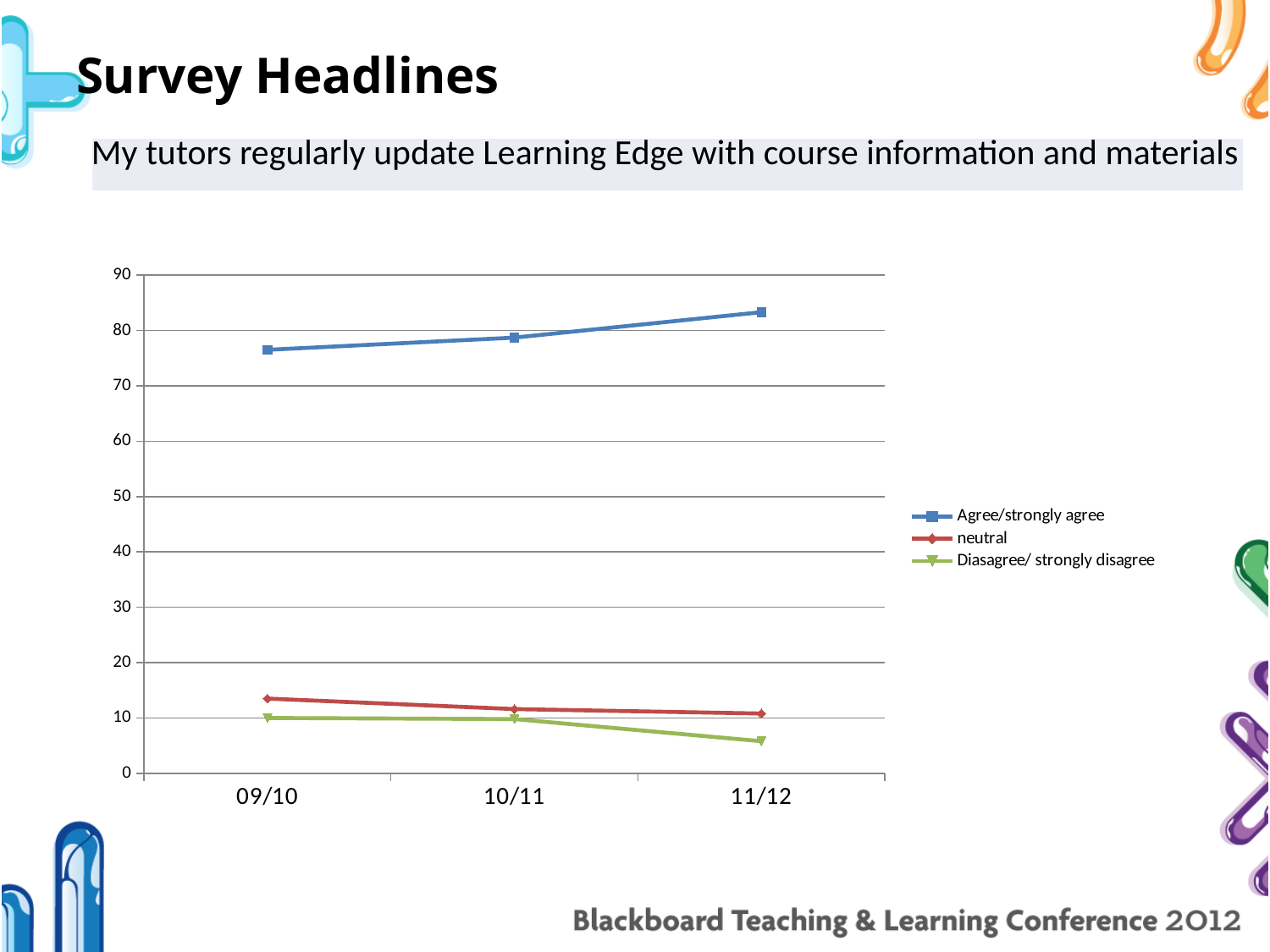
Is the Diasagree/ strongly disagree value for 11/12 greater or less than 10? less How many academic years are plotted along the x axis? 3 In 09/10, which is larger: the neutral value or the Diasagree/ strongly disagree value? neutral Is the Agree/strongly agree value for 09/10 greater or less than 80? less Does the Diasagree/ strongly disagree line rise or fall from 09/10 to 11/12? Falls Does the Agree/strongly agree line rise or fall from 09/10 to 11/12? Rises In which year is the Diasagree/ strongly disagree value lowest? 11/12 How many series does the legend list? 3 Which series has the highest values across all years? Agree/strongly agree In which year is the Agree/strongly agree value highest? 11/12 What kind of chart is shown on the slide? Line chart Is the Agree/strongly agree value for 11/12 greater or less than 80? greater